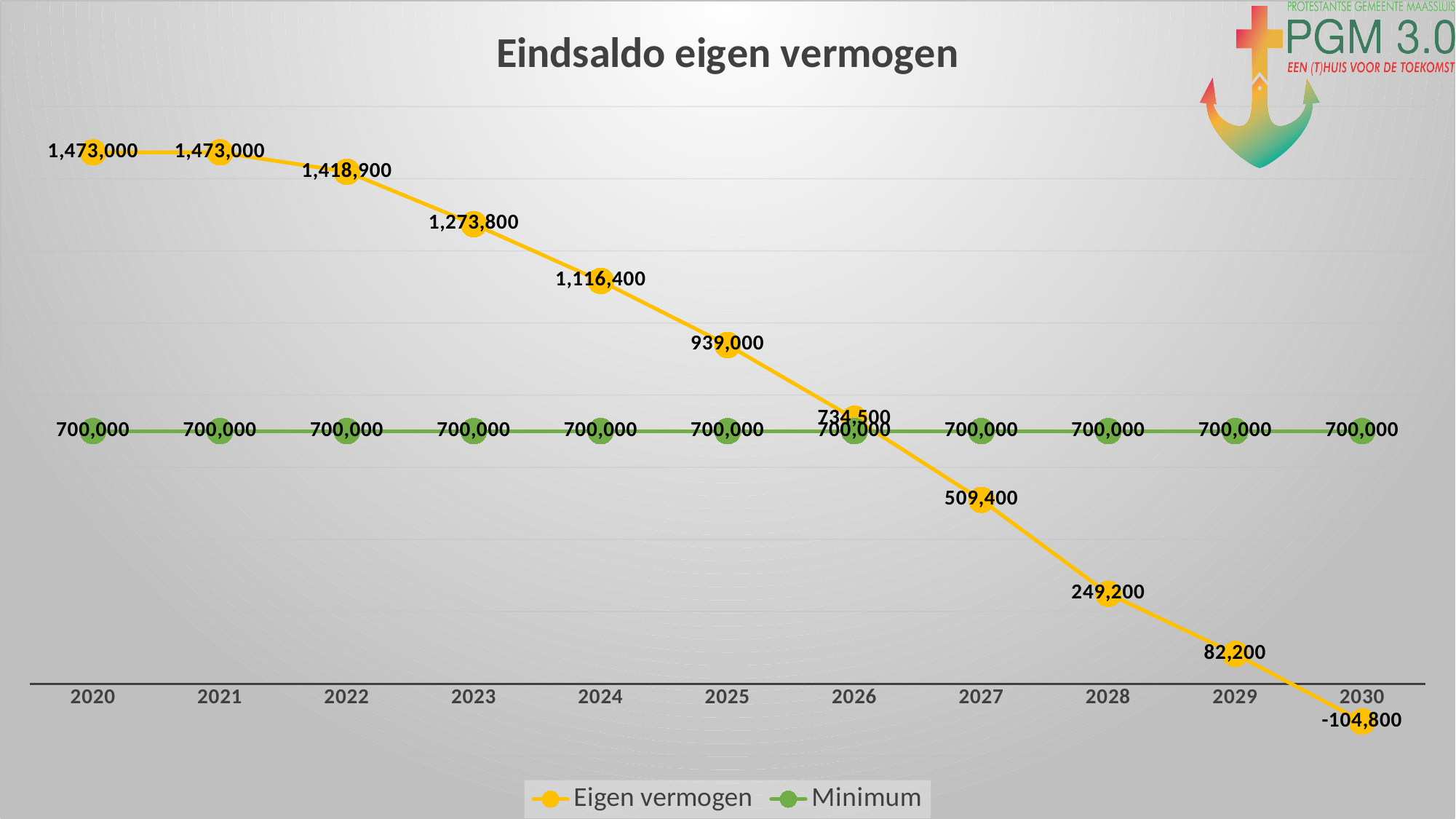
What is the value of Eigen vermogen in 2024? 1,116,400 What kind of chart is shown? Line chart Does Eigen vermogen rise or fall from 2021 to 2030? Fall What is the value of Minimum in 2027? 700,000 How many years are shown on the x axis? 11 Which is larger in 2028: Eigen vermogen or Minimum? Minimum How many series does the legend list? 2 In which year is Eigen vermogen lowest? 2030 What is the difference between Eigen vermogen in 2025 and in 2026? 204,500 What is the value of Eigen vermogen in 2030? -104,800 What is the title of the chart? Eindsaldo eigen vermogen What colour is the Minimum line? Green